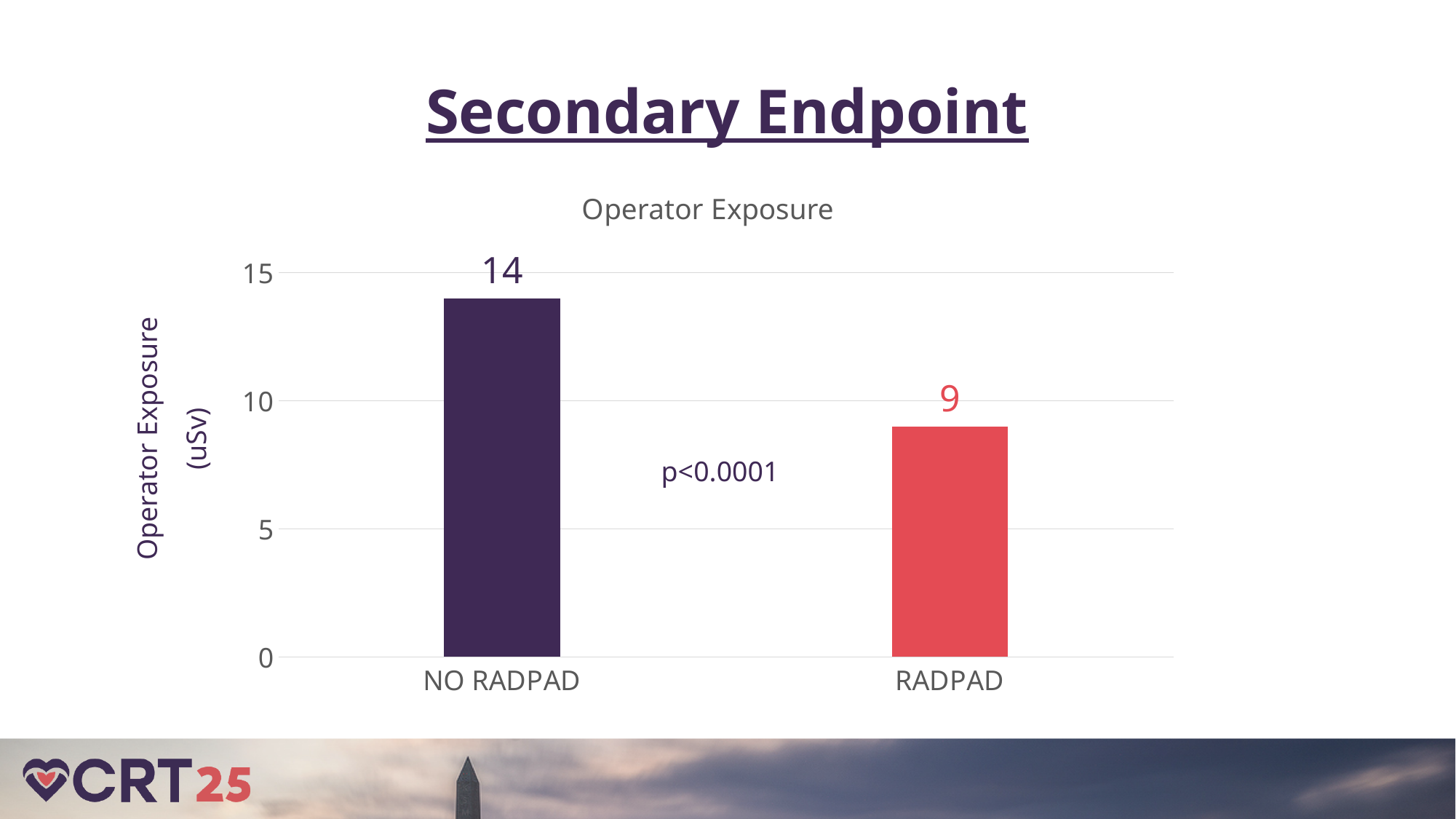
What is the operator exposure value for RADPAD? 9 Which has a larger operator exposure, NO RADPAD or RADPAD? NO RADPAD Which category has the lowest operator exposure? RADPAD What is the title of the chart? Operator Exposure Is the value for RADPAD greater or less than 10? less What is the difference in operator exposure between NO RADPAD and RADPAD? 5 Is the value for NO RADPAD greater or less than 10? greater How many categories are shown on the chart? 2 What kind of chart is shown on the slide? Bar chart What is the operator exposure value for NO RADPAD? 14 Which category has the highest operator exposure? NO RADPAD What p-value is shown on the chart? p<0.0001